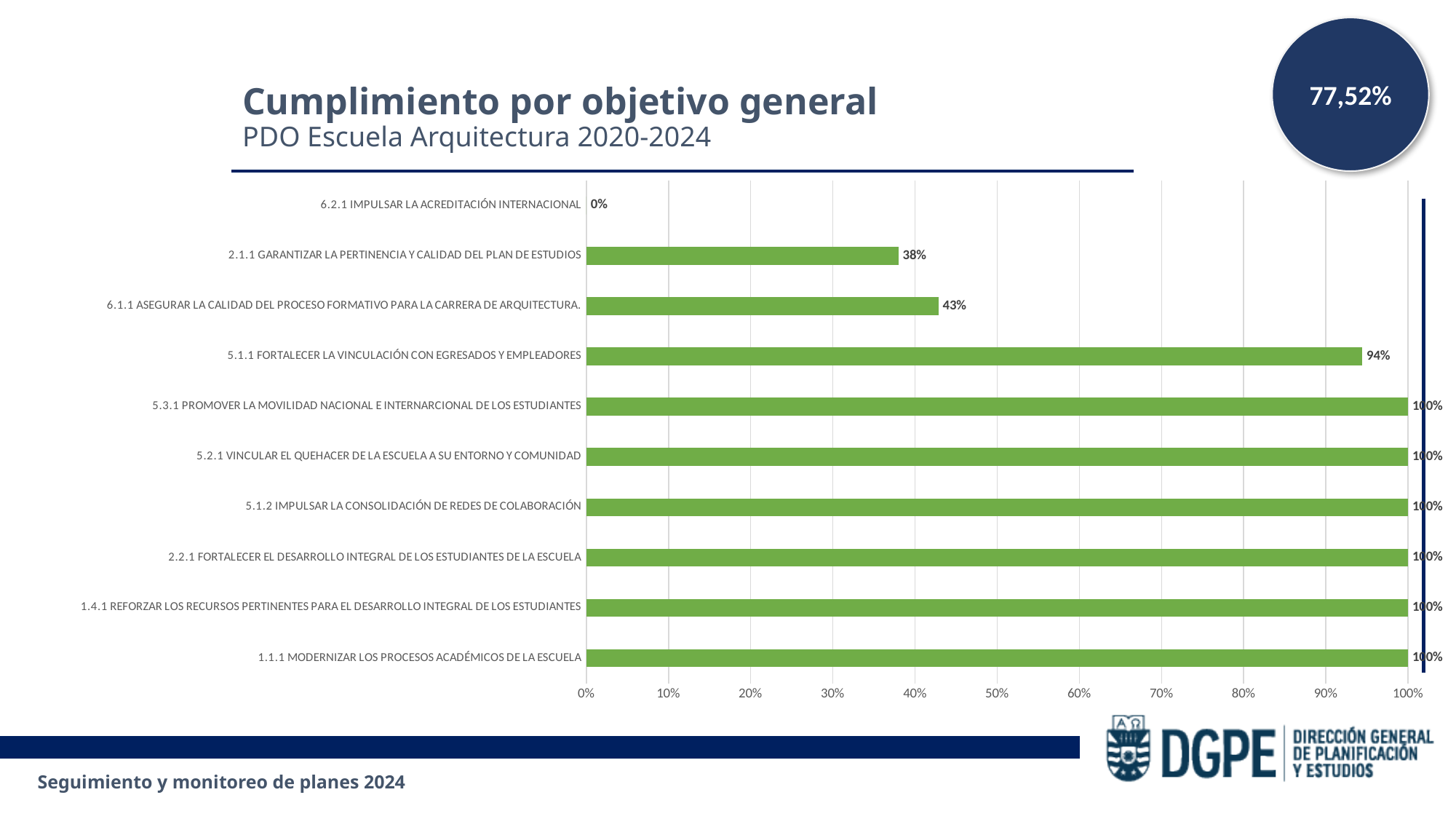
How many categories have a value of 100%? 6 What is the value for 5.1.1 FORTALECER LA VINCULACIÓN CON EGRESADOS Y EMPLEADORES? 94% What is the title of the chart? Cumplimiento por objetivo general What kind of chart is shown on the slide? bar chart What is the value for 2.1.1 GARANTIZAR LA PERTINENCIA Y CALIDAD DEL PLAN DE ESTUDIOS? 38% How many categories are shown in the chart? 10 Which category has the lowest value? 6.2.1 IMPULSAR LA ACREDITACIÓN INTERNACIONAL What is the value for 6.1.1 ASEGURAR LA CALIDAD DEL PROCESO FORMATIVO PARA LA CARRERA DE ARQUITECTURA.? 43% What is the difference between the values for 5.1.1 FORTALECER LA VINCULACIÓN CON EGRESADOS Y EMPLEADORES and 6.1.1 ASEGURAR LA CALIDAD DEL PROCESO FORMATIVO PARA LA CARRERA DE ARQUITECTURA.? 51% What is the value for 6.2.1 IMPULSAR LA ACREDITACIÓN INTERNACIONAL? 0% Is the value for 5.1.1 FORTALECER LA VINCULACIÓN CON EGRESADOS Y EMPLEADORES greater or less than 90%? greater Which is larger, the value for 2.1.1 GARANTIZAR LA PERTINENCIA Y CALIDAD DEL PLAN DE ESTUDIOS or the value for 6.1.1 ASEGURAR LA CALIDAD DEL PROCESO FORMATIVO PARA LA CARRERA DE ARQUITECTURA.? 6.1.1 ASEGURAR LA CALIDAD DEL PROCESO FORMATIVO PARA LA CARRERA DE ARQUITECTURA.